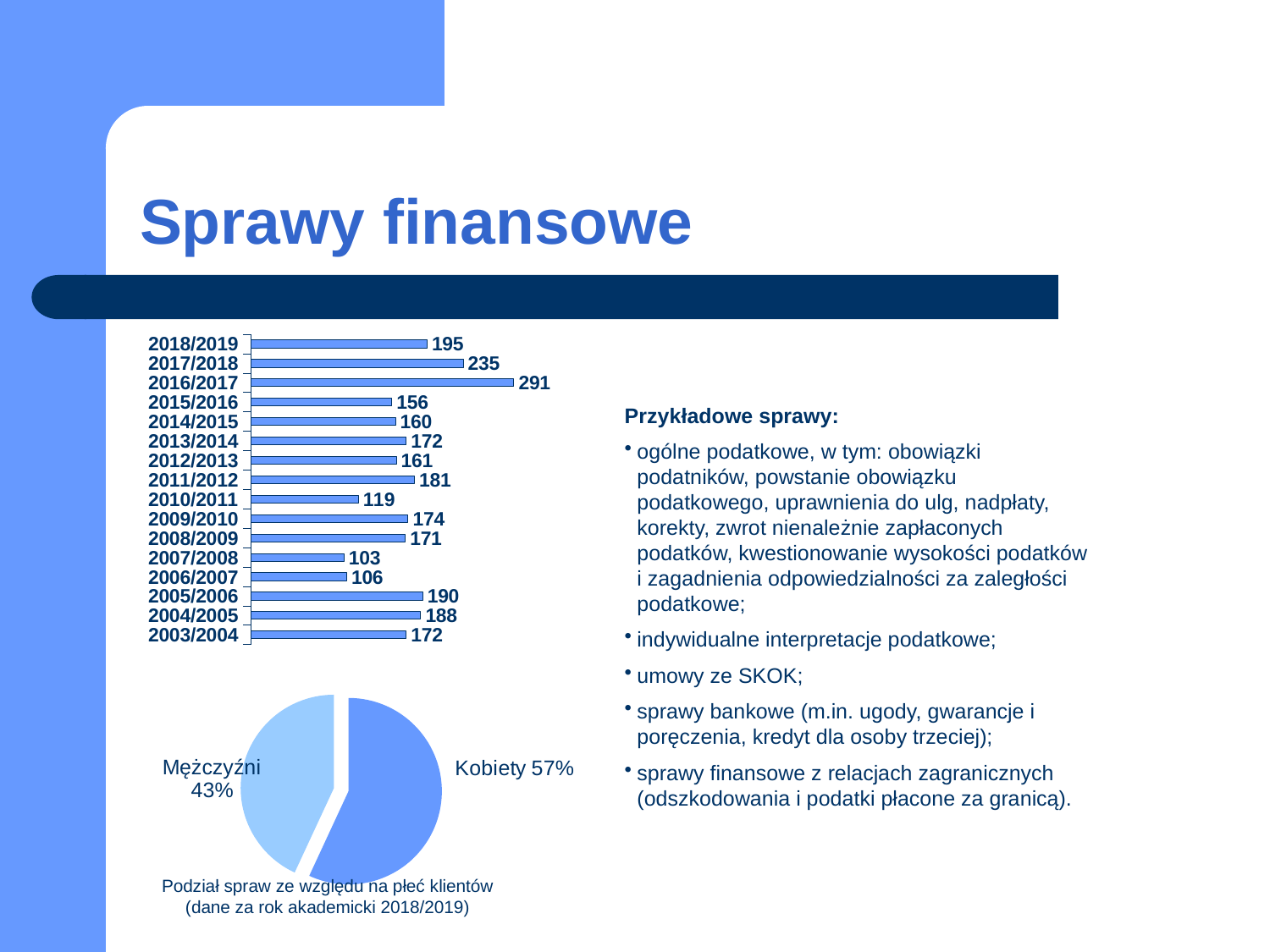
In the bar chart at the top left of the slide, what is the value for 2016/2017? 291 In the bar chart at the top left of the slide, which academic year has the lowest value? 2007/2008 In the bar chart at the top left of the slide, what is the difference between the values for 2017/2018 and 2018/2019? 40 What kind of chart is shown at the top left of the slide? Bar chart How many academic years are shown in the bar chart at the top left of the slide? 16 In the bar chart at the top left of the slide, which academic year has the highest value? 2016/2017 In the bar chart at the top left of the slide, what is the value for 2010/2011? 119 In the pie chart at the bottom left of the slide, what share is labelled Mężczyźni? 43% What kind of chart is shown at the bottom left of the slide? Pie chart In the bar chart at the top left of the slide, which is larger: the value for 2005/2006 or the value for 2004/2005? 2005/2006 In the pie chart at the bottom left of the slide, what share is labelled Kobiety? 57% In the bar chart at the top left of the slide, what is the value for 2018/2019? 195